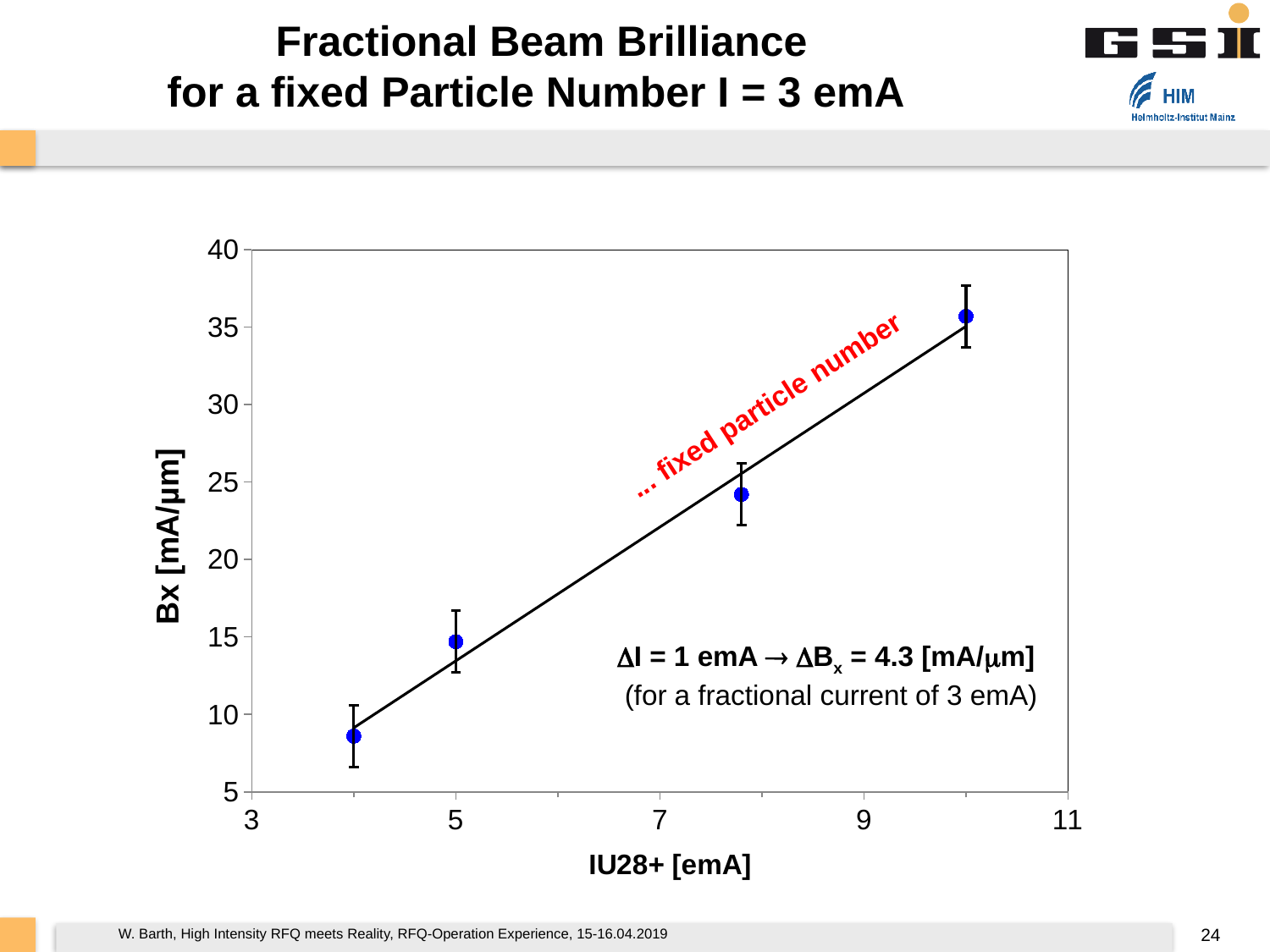
Do the Bx values rise or fall as IU28+ increases along the x axis? Rise What kind of chart is shown on the slide? Scatter plot with error bars and a fitted line Is the Bx value for the data point near IU28+ = 8 emA greater or less than 20? greater According to the annotation on the chart, what change in Bx corresponds to ΔI = 1 emA? 4.3 [mA/μm] Is the Bx value for the data point at IU28+ = 10 emA greater or less than 30? greater What is the label of the x axis of the chart? IU28+ [emA] How many data points are plotted on the chart? 4 Is the Bx value for the data point at IU28+ = 4 emA greater or less than 10? less Which data point has the larger Bx value: the one at IU28+ = 5 emA or the one at IU28+ = 10 emA? IU28+ = 10 emA